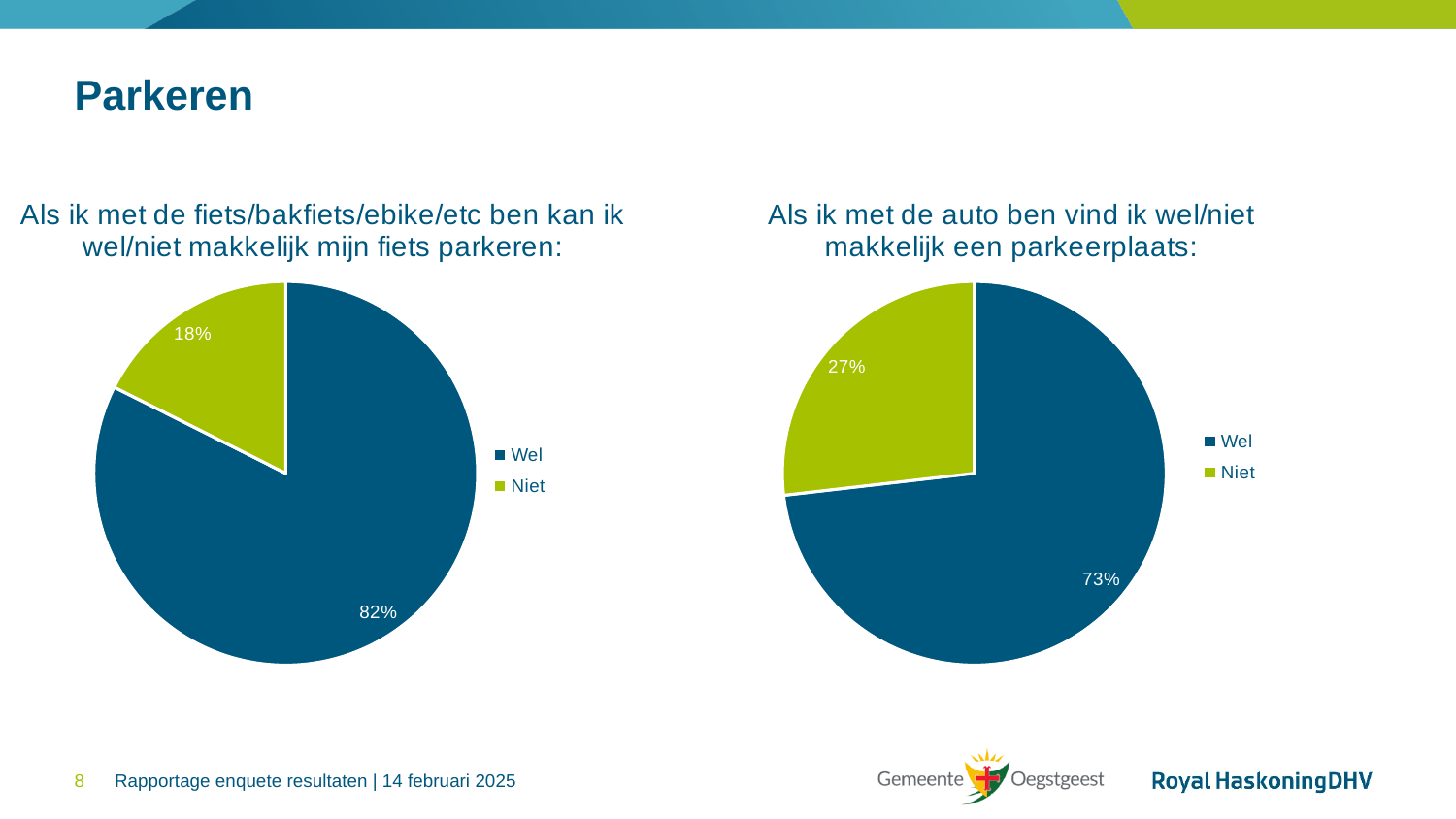
In the right pie chart (about finding a car parking space), what percentage is shown for 'Wel'? 73% In the right pie chart, what colour is the 'Niet' slice? green In the right pie chart, what is the difference in percentage points between 'Wel' and 'Niet'? 46 In the left pie chart, which category has the largest share? Wel Which chart has the larger 'Niet' share, the left pie chart or the right pie chart? the right pie chart What type of chart is used on the left side of the slide? pie chart In the right pie chart (about finding a car parking space), what percentage is shown for 'Niet'? 27% How many categories does the legend of the right pie chart list? 2 In the left pie chart (about parking a bike), what percentage is shown for 'Niet'? 18% In the left pie chart (about parking a bike), what percentage is shown for 'Wel'? 82% In the left pie chart, what is the difference in percentage points between 'Wel' and 'Niet'? 64 In the right pie chart, which category has the smallest share? Niet